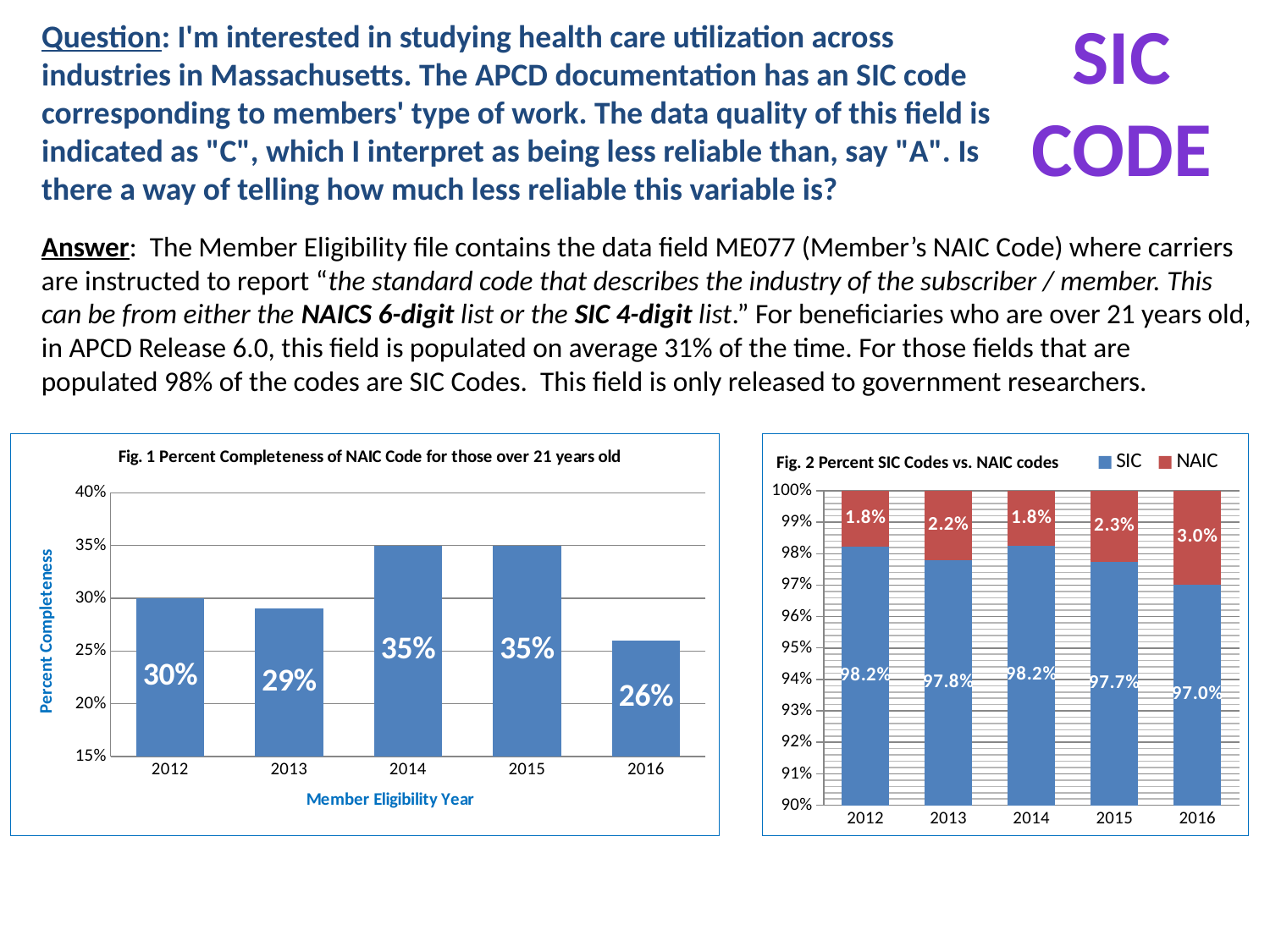
In Fig. 2 Percent SIC Codes vs. NAIC codes, how many series does the legend list? 2 In Fig. 1 Percent Completeness of NAIC Code for those over 21 years old, what kind of chart is shown? Bar chart In Fig. 1 Percent Completeness of NAIC Code for those over 21 years old, which is larger, the value for 2012 or the value for 2013? 2012 In Fig. 1 Percent Completeness of NAIC Code for those over 21 years old, what is the label of the y axis? Percent Completeness In Fig. 2 Percent SIC Codes vs. NAIC codes, what is the total of the stacked bar for 2013? 100% In Fig. 1 Percent Completeness of NAIC Code for those over 21 years old, which year has the lowest percent completeness? 2016 In Fig. 1 Percent Completeness of NAIC Code for those over 21 years old, how many years are shown on the x axis? 5 In Fig. 2 Percent SIC Codes vs. NAIC codes, which year has the highest NAIC share? 2016 In Fig. 1 Percent Completeness of NAIC Code for those over 21 years old, what is the difference in percent completeness between 2014 and 2013? 6% In Fig. 2 Percent SIC Codes vs. NAIC codes, what is the SIC share for 2015? 97.7% In Fig. 1 Percent Completeness of NAIC Code for those over 21 years old, what is the percent completeness for 2016? 26% In Fig. 2 Percent SIC Codes vs. NAIC codes, what is the NAIC share for 2016? 3.0%